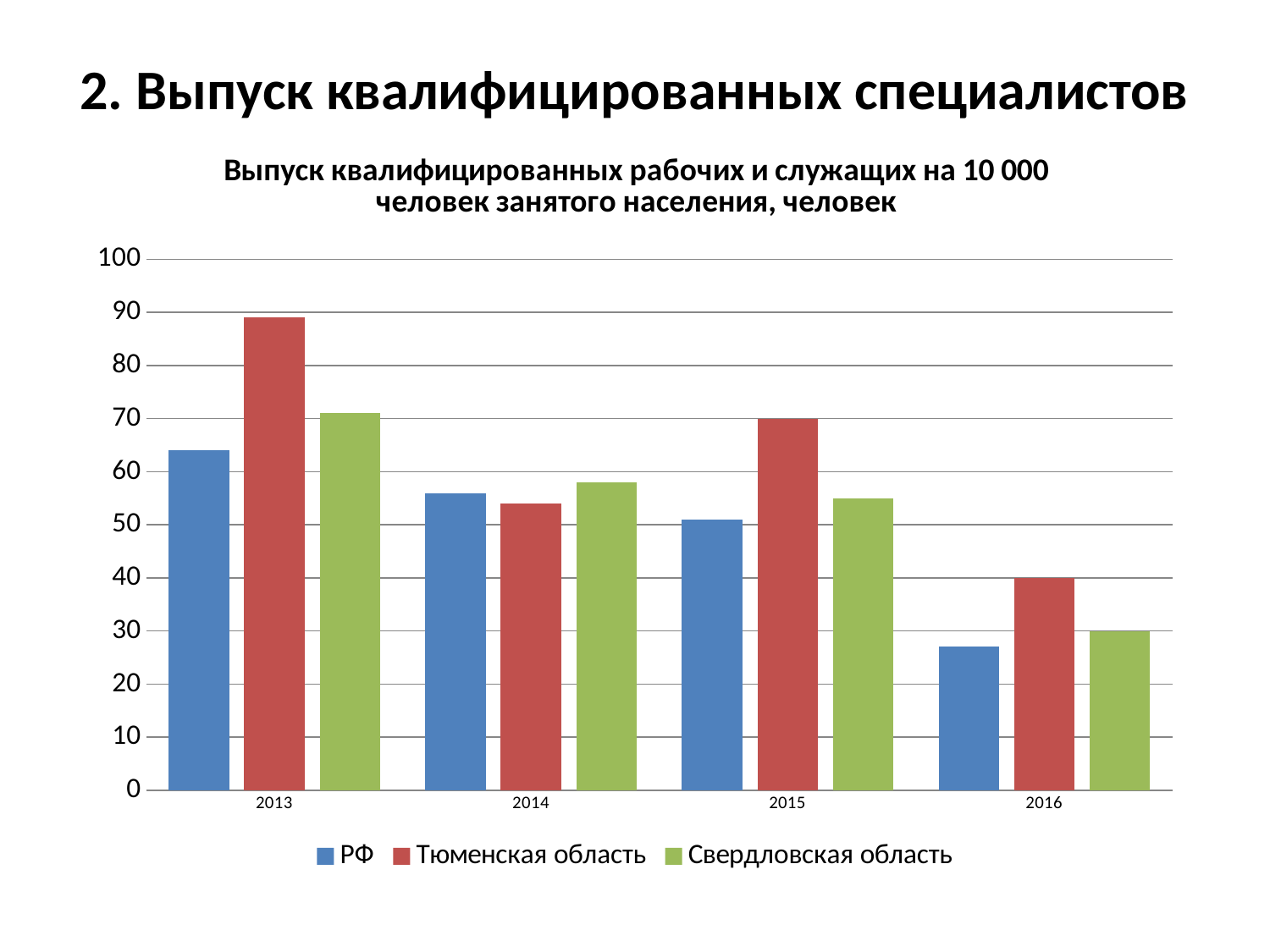
Do the values for РФ rise or fall from 2013 to 2016? fall Which year has the lowest value for РФ? 2016 What is the value for Свердловская область in 2016? 30 Which is larger in 2015: the value for РФ or the value for Тюменская область? Тюменская область How many years are shown on the x axis? 4 Which year has the highest value for Тюменская область? 2013 What is the value for Тюменская область in 2015? 70 Is the value for Тюменская область in 2013 greater or less than 80? greater What kind of chart is shown on the slide? bar chart How many series does the legend list? 3 What is the value for Тюменская область in 2016? 40 Is the value for РФ in 2016 greater or less than 30? less